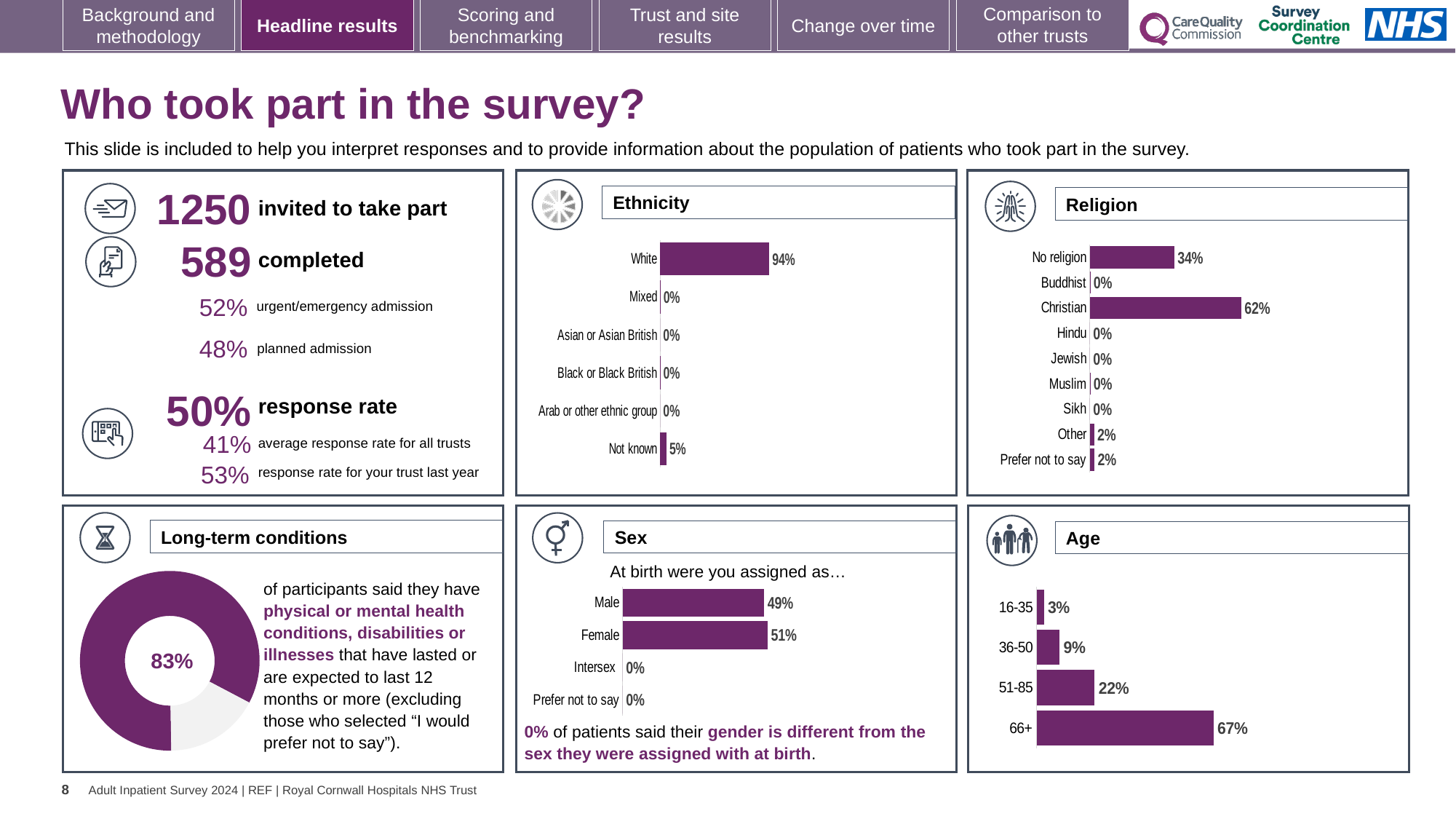
In the Religion chart, what is the value for No religion? 34% In the Religion chart, which category has the highest value? Christian In the Age chart, what is the value for 51-85? 22% In the Sex chart, what is the value for Male? 49% In the Religion chart, what is the difference between Christian and No religion? 28% In the Age chart, do the values rise or fall as the age groups get older? rise How many categories does the Religion chart show? 9 In the Sex chart, which is larger, Male or Female? Female In the Ethnicity chart, what percentage of respondents are White? 94% In the Age chart, which age group has the lowest value? 16-35 What kind of chart is the Long-term conditions chart? doughnut chart In the Ethnicity chart, what percentage of respondents are Not known? 5%